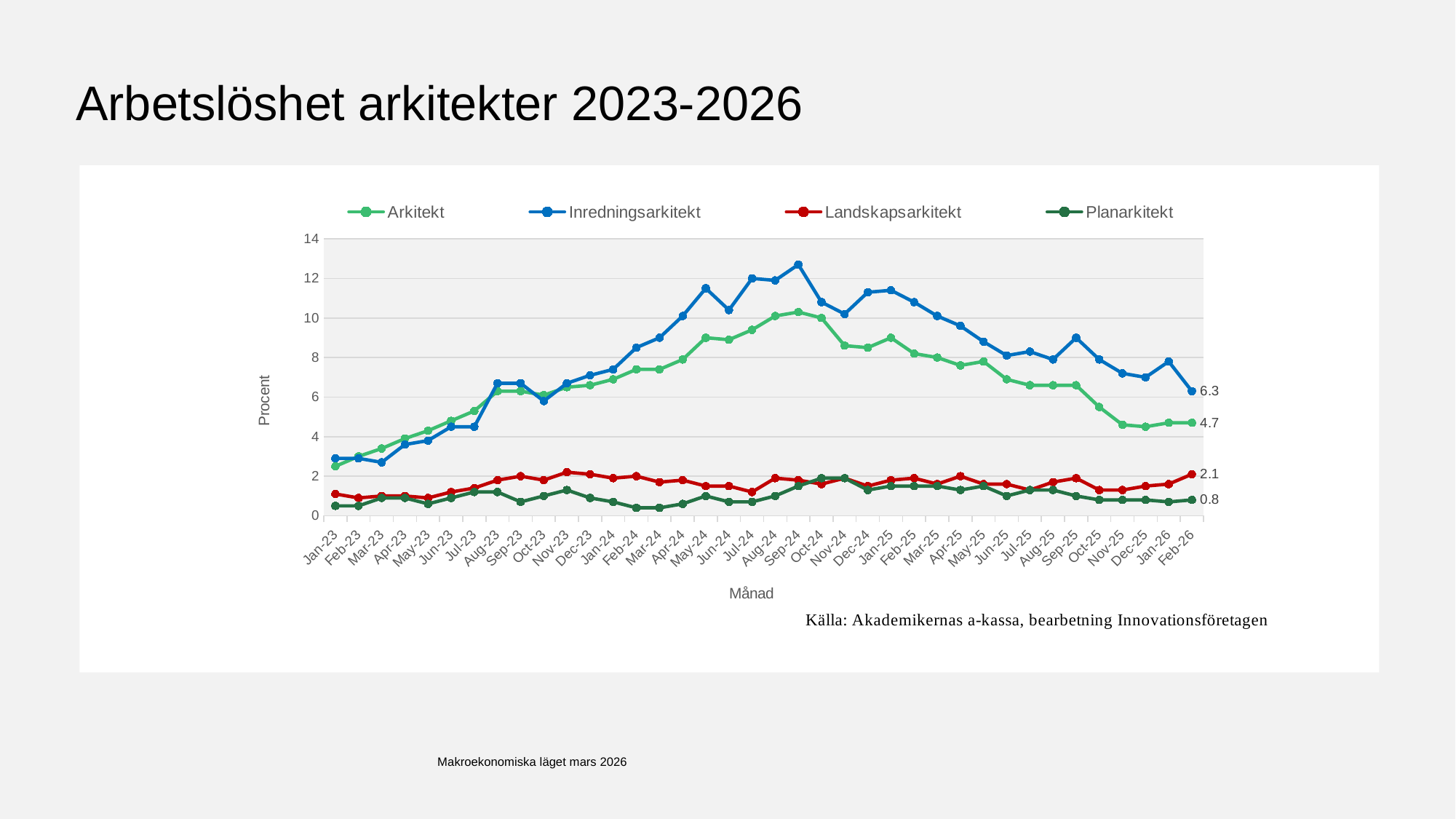
Which series has the lowest value at Feb-26? Planarkitekt What is the difference between the Feb-26 values for Inredningsarkitekt and Arkitekt? 1.6 What is the title of the vertical axis? Procent Which series has the highest value at Feb-26? Inredningsarkitekt What is the value for Planarkitekt at Feb-26? 0.8 Is the value for Planarkitekt at Jan-23 greater or less than 2? less What is the value for Arkitekt at Feb-26? 4.7 What is the value for Landskapsarkitekt at Feb-26? 2.1 What kind of chart is shown on the slide? Line chart Is the value for Inredningsarkitekt at Sep-24 greater or less than 12? greater How many series does the legend list? 4 What is the value for Inredningsarkitekt at Feb-26? 6.3